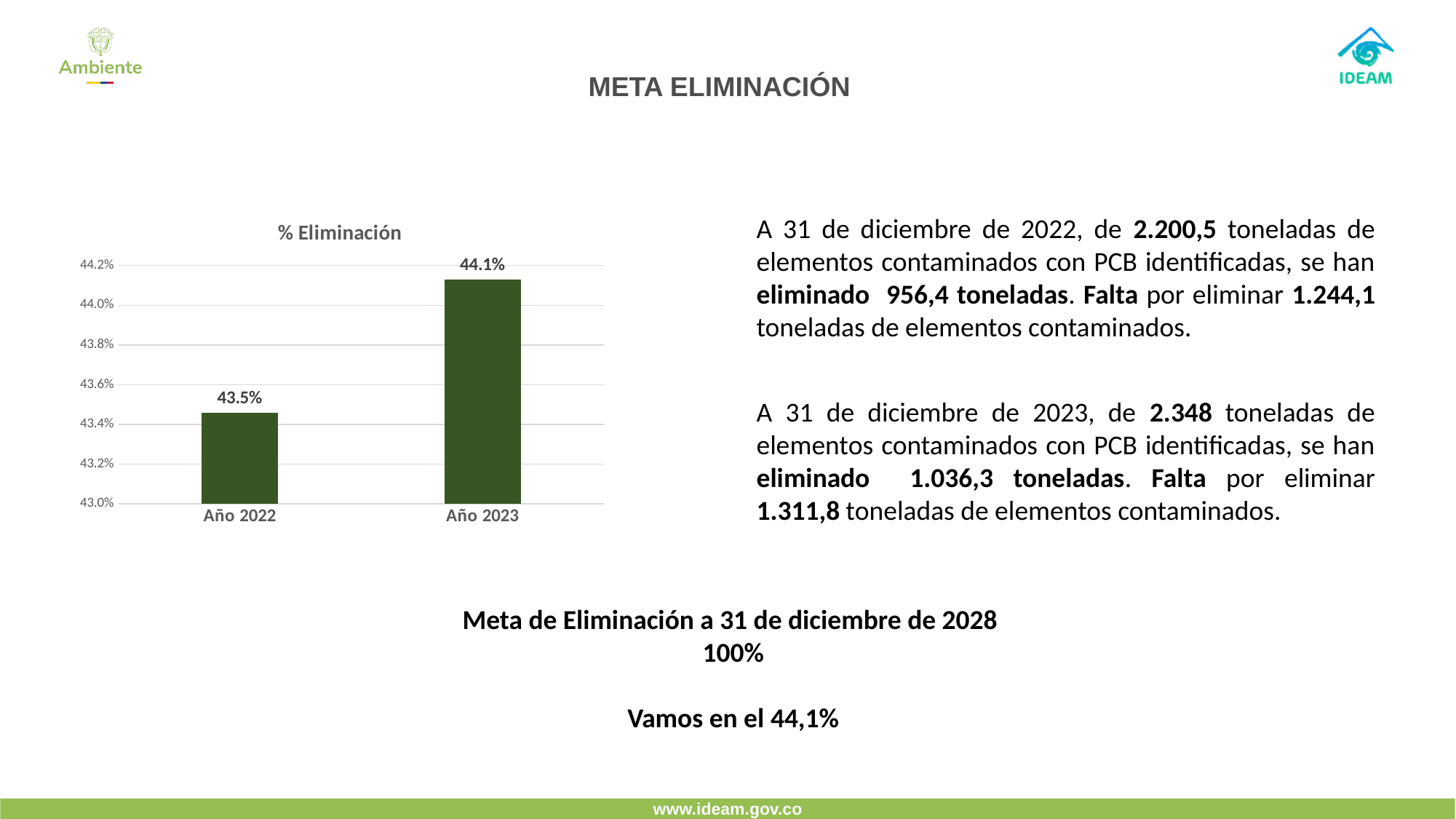
Does the % Eliminación rise or fall from Año 2022 to Año 2023? rise Is the value for Año 2022 greater or less than 44.0%? less What is the title of the chart on the slide? % Eliminación What kind of chart is shown on the slide? bar chart Which is larger, the % Eliminación for Año 2022 or for Año 2023? Año 2023 How many categories are shown in the % Eliminación chart? 2 What is the value for Año 2023 in the % Eliminación chart? 44.1% Which year has the highest % Eliminación? Año 2023 Which year has the lowest % Eliminación? Año 2022 What is the value for Año 2022 in the % Eliminación chart? 43.5% What is the difference in % Eliminación between Año 2023 and Año 2022? 0.6% Is the value for Año 2023 greater or less than 44.0%? greater